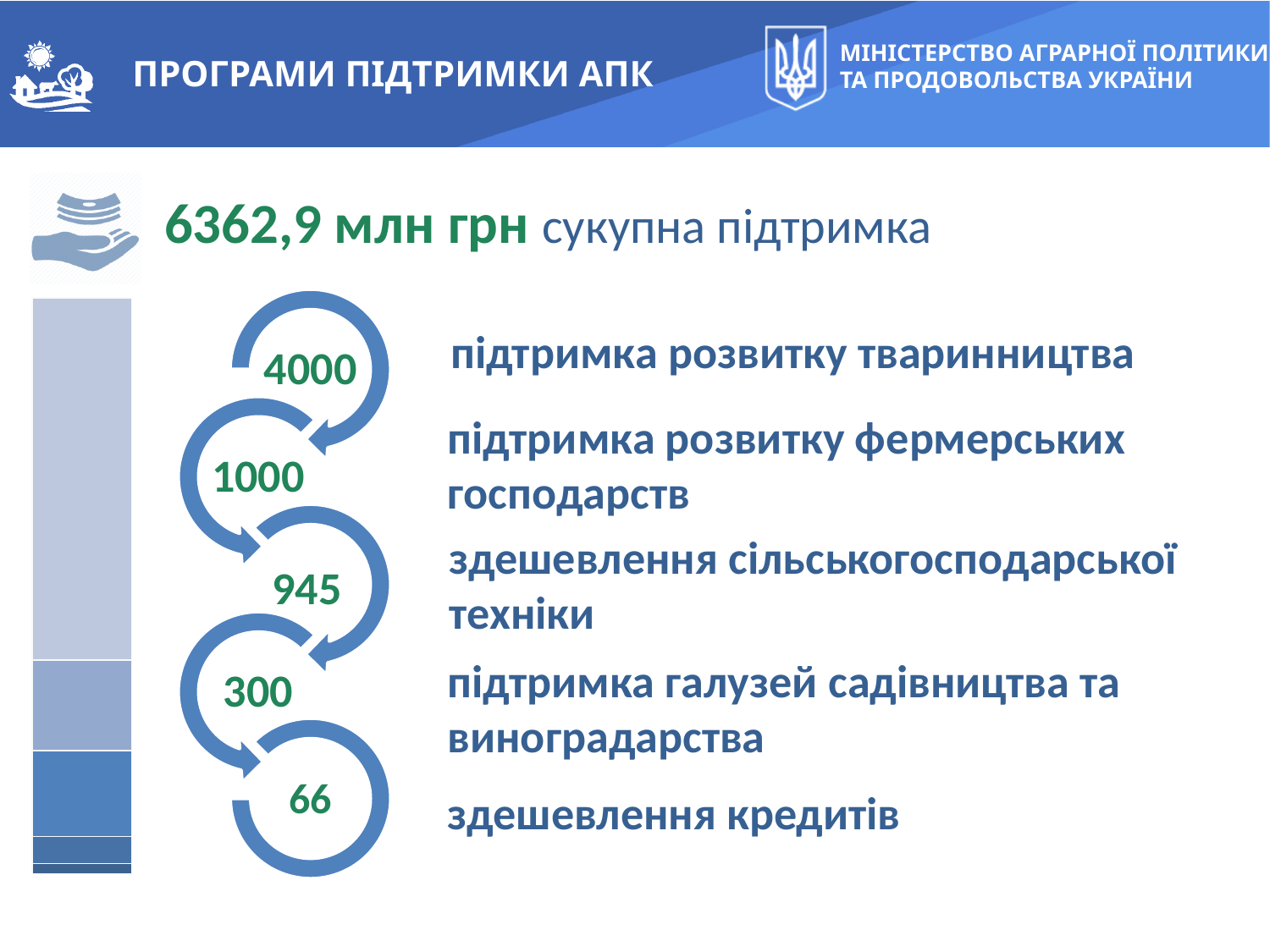
What kind of chart is shown on the left side of the slide? stacked bar chart Which is larger: the value for «здешевлення сільськогосподарської техніки» or for «підтримка галузей садівництва та виноградарства»? здешевлення сільськогосподарської техніки What is the difference between the values for «підтримка розвитку тваринництва» and «підтримка розвитку фермерських господарств»? 3000 What total support amount («сукупна підтримка») is stated on the slide? 6362,9 млн грн How many support programs are listed with values on the slide? 5 What value is shown for «підтримка розвитку тваринництва»? 4000 What value is shown for «підтримка галузей садівництва та виноградарства»? 300 What value is shown for «здешевлення сільськогосподарської техніки»? 945 What value is shown for «здешевлення кредитів»? 66 What value is shown for «підтримка розвитку фермерських господарств»? 1000 Which support program has the lowest value? здешевлення кредитів Which support program has the highest value? підтримка розвитку тваринництва